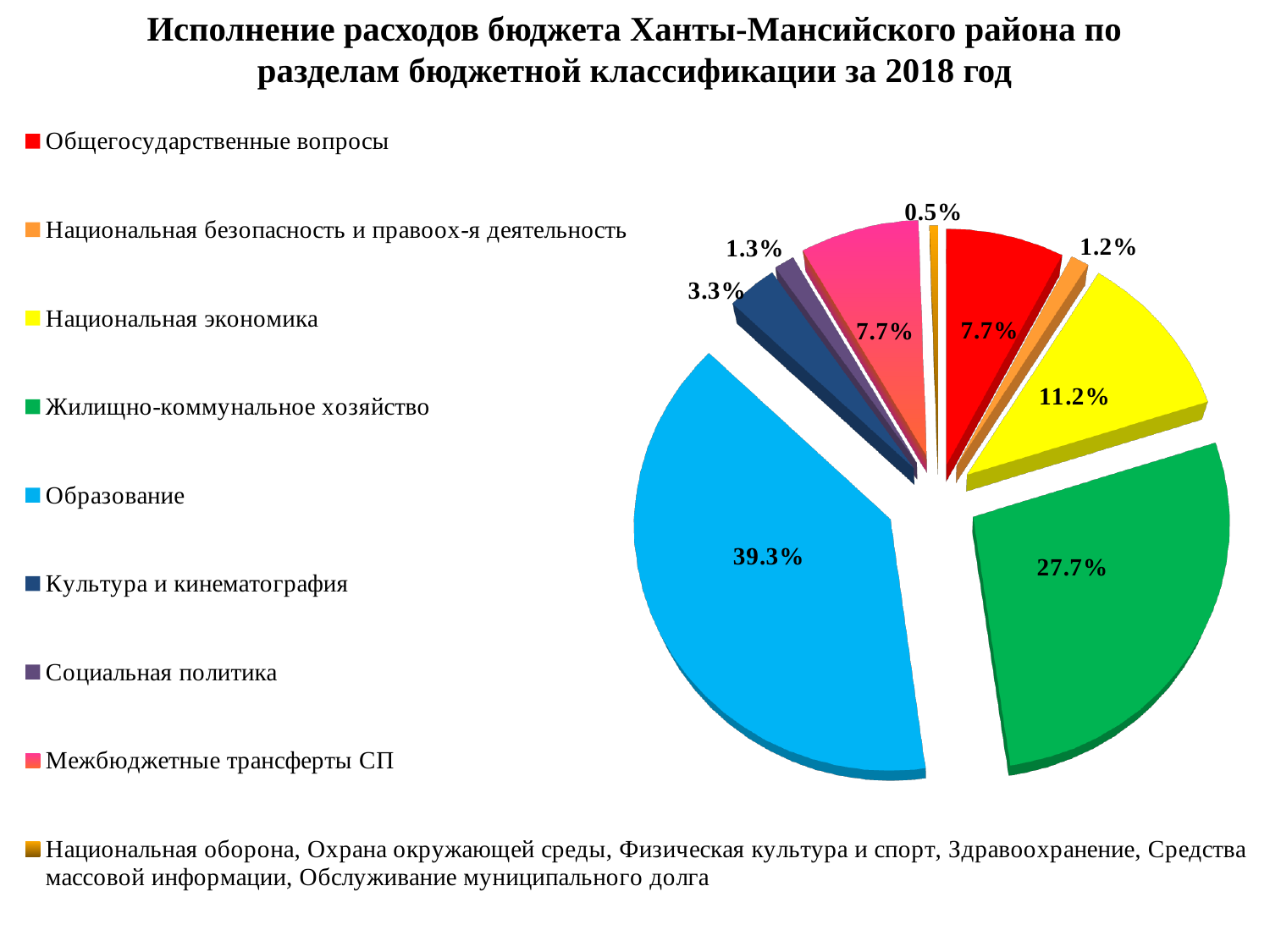
What is the difference between the shares of Образование and Жилищно-коммунальное хозяйство? 11.6% What share of the pie does Национальная безопасность и правоох-я деятельность have? 1.2% Which category has the largest slice of the pie? Образование How many categories does the legend list? 9 Which is larger, the share of Национальная экономика or the share of Общегосударственные вопросы? Национальная экономика What share of the pie does Национальная экономика have? 11.2% What share of the pie does Культура и кинематография have? 3.3% What kind of chart is shown on the slide? pie chart What colour is the slice for Образование? light blue What share of the pie does Жилищно-коммунальное хозяйство have? 27.7% Which category has the smallest slice of the pie? Национальная оборона, Охрана окружающей среды, Физическая культура и спорт, Здравоохранение, Средства массовой информации, Обслуживание муниципального долга What share of the pie does Образование have? 39.3%